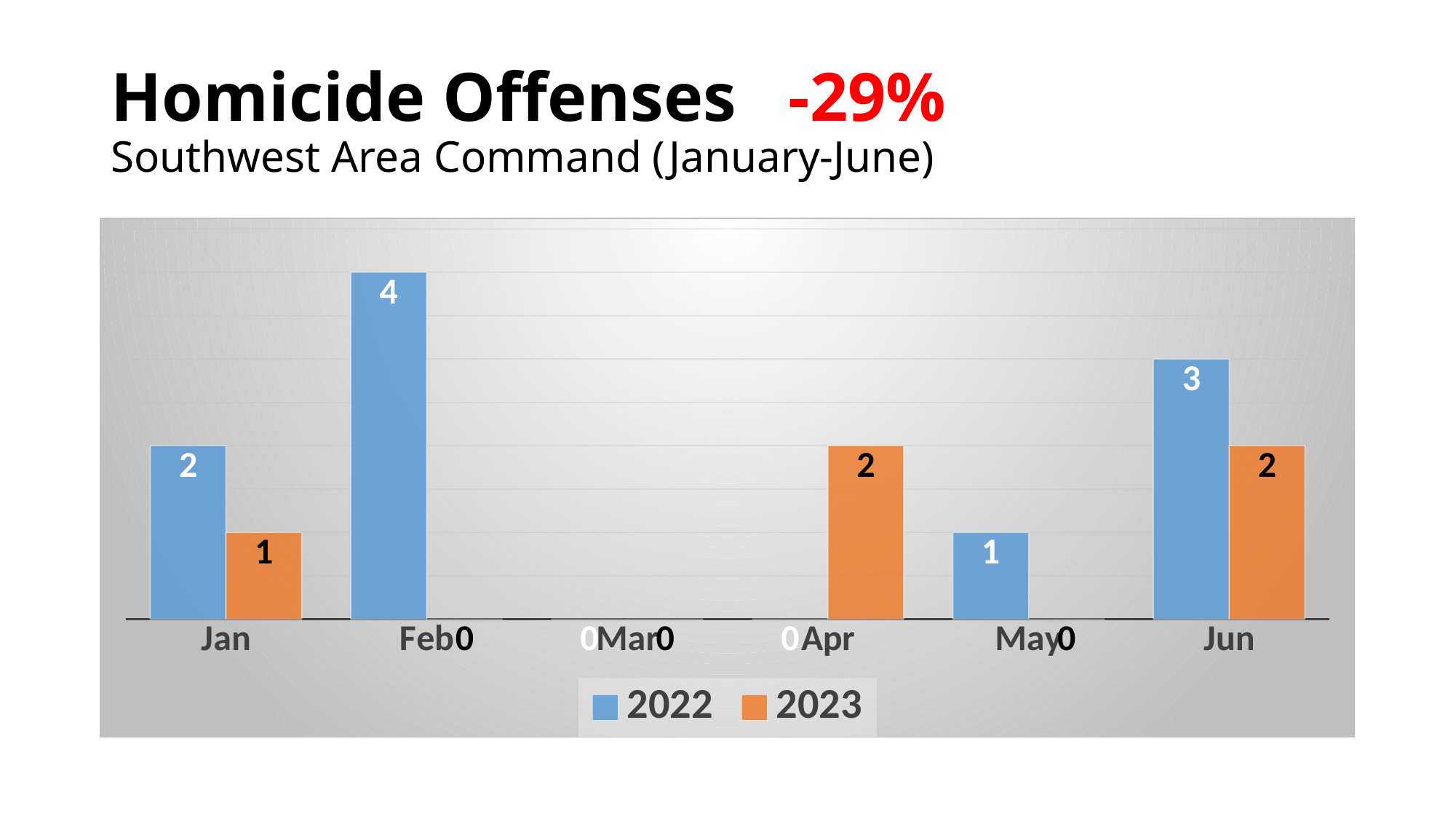
How many months are shown on the x axis? 6 Which month has the highest value for 2022? Feb What is the value for 2022 in Feb? 4 What is the value for 2023 in Apr? 2 What is the value for 2023 in Jan? 1 What is the value for 2022 in Jun? 3 What is the difference between the 2022 values for Feb and Jan? 2 What is the difference between the 2022 and 2023 values in Jun? 1 How many series does the legend list? 2 What percentage change is shown in red next to the chart title? -29% What kind of chart is shown on the slide? Bar chart Which is larger in Jan, the 2022 value or the 2023 value? 2022